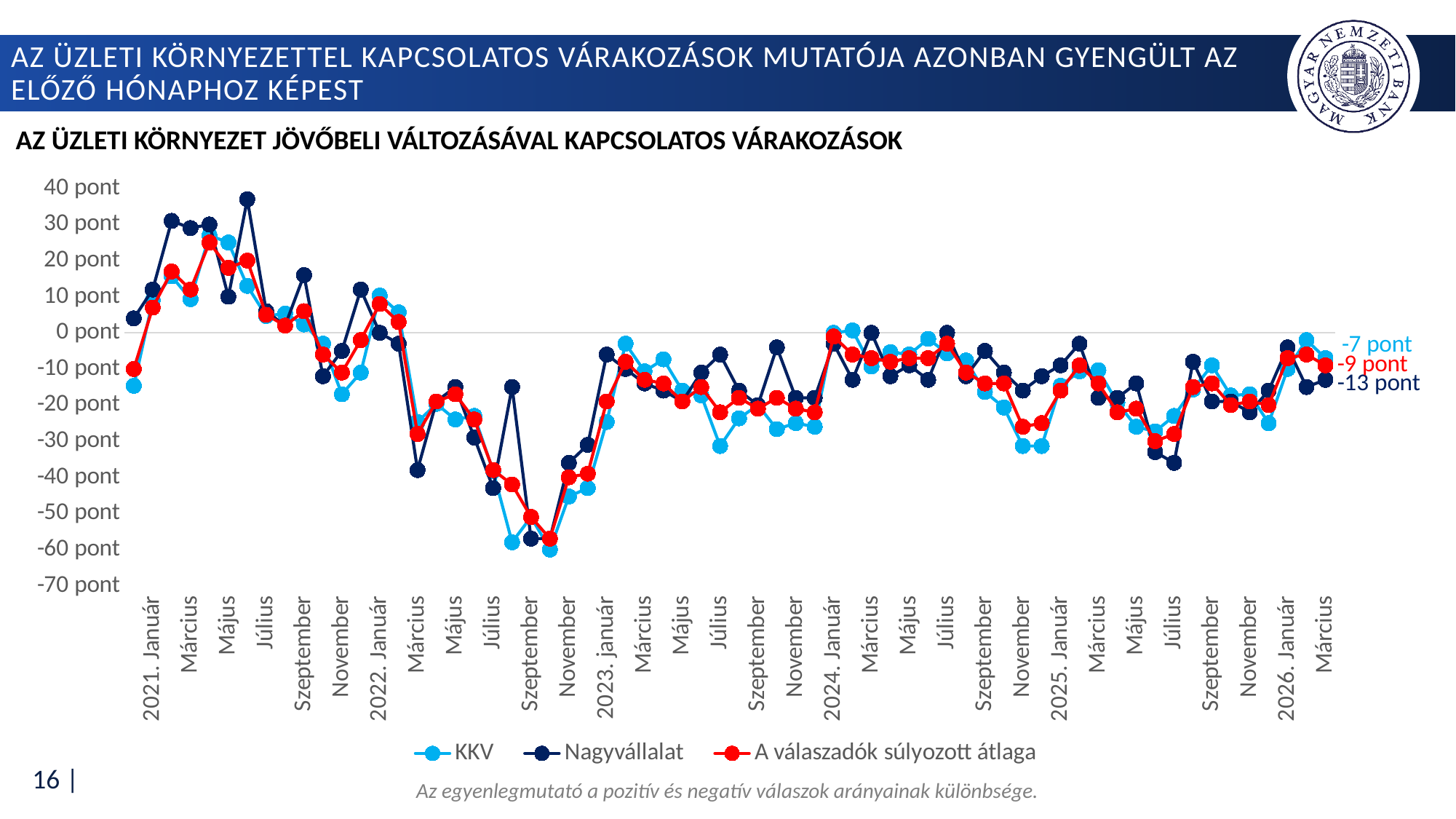
Is the lowest value of the KKV series in 2022 greater or less than -50 pont? less What is the difference between the latest KKV value and the latest Nagyvállalat value? 6 pont Which series has the lowest value at the right end of the chart? Nagyvállalat At the right end of the chart, which series has the higher value: KKV or Nagyvállalat? KKV Between 2022. Január and Szeptember 2022, does the KKV series rise or fall overall? fall Is the peak value of the Nagyvállalat series in 2021 greater or less than 30 pont? greater What is the latest value of the Nagyvállalat series shown at the right end of the chart? -13 pont What is the title of the chart? AZ ÜZLETI KÖRNYEZET JÖVŐBELI VÁLTOZÁSÁVAL KAPCSOLATOS VÁRAKOZÁSOK What is the latest value of the 'A válaszadók súlyozott átlaga' series shown at the right end of the chart? -9 pont What is the latest value of the KKV series shown at the right end of the chart? -7 pont How many series does the legend list? 3 What kind of chart is shown on the slide? line chart